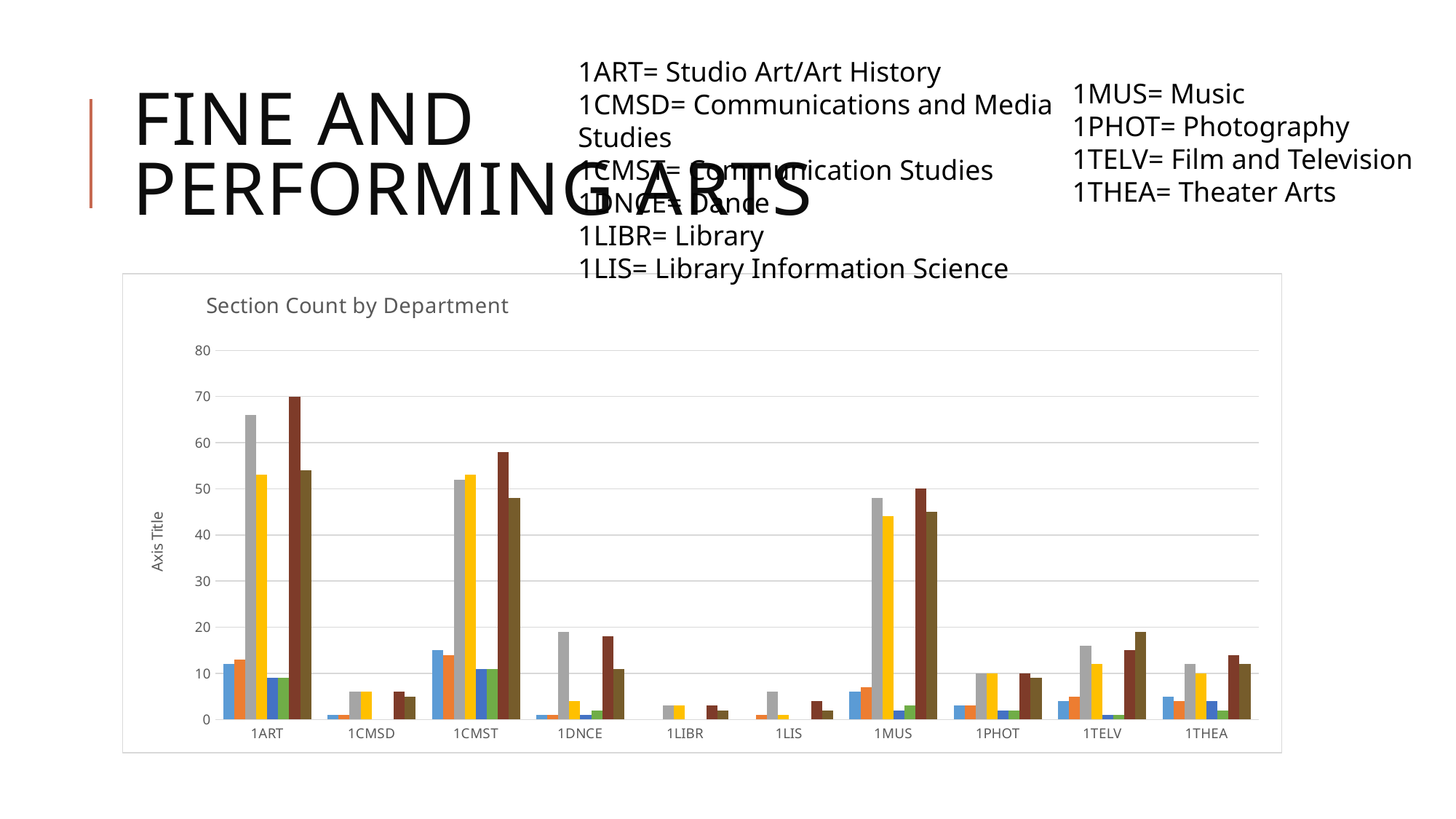
How many department categories are shown on the x axis of the chart? 10 What label is shown on the vertical axis of the chart? Axis Title Which has a taller tallest bar, 1PHOT or 1CMST? 1CMST Is the tallest bar for 1LIBR greater or less than 10? less Which has a taller tallest bar, 1ART or 1MUS? 1ART What is the title of the chart? Section Count by Department Is the tallest bar for 1TELV greater or less than 30? less Is the tallest bar for 1CMST greater or less than 50? greater Which department category contains the tallest bar in the chart? 1ART What kind of chart is shown on the slide? bar chart